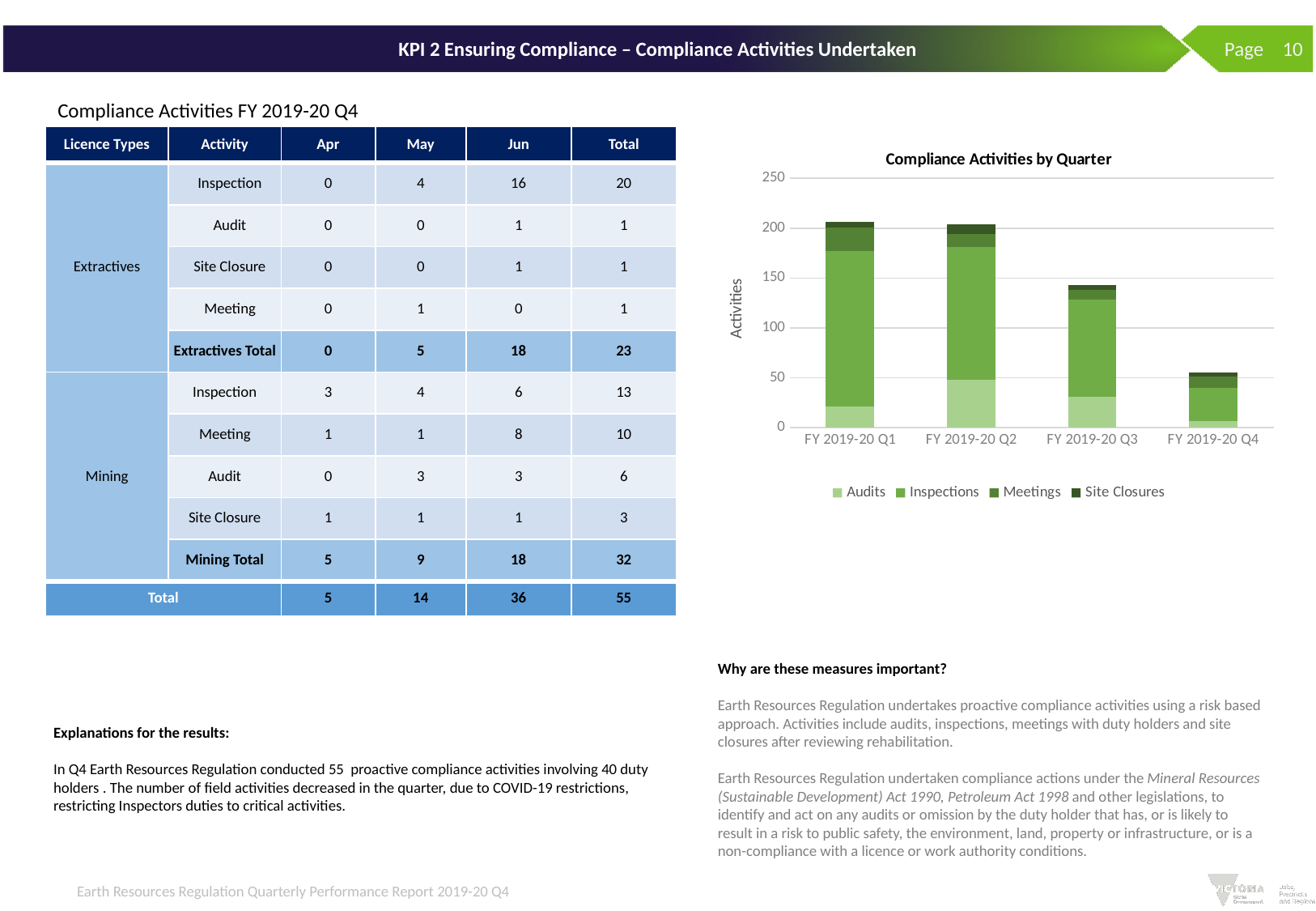
In the 'Compliance Activities by Quarter' chart, is the total for FY 2019-20 Q3 greater or less than 150? less What is the y-axis label of the 'Compliance Activities by Quarter' chart? Activities Which quarter has the lowest total in the 'Compliance Activities by Quarter' chart? FY 2019-20 Q4 In the 'Compliance Activities by Quarter' chart, is the total for FY 2019-20 Q1 greater or less than 200? greater In the 'Compliance Activities by Quarter' chart, is the total for FY 2019-20 Q2 greater or less than 150? greater In the 'Compliance Activities by Quarter' chart, which has the larger total, FY 2019-20 Q3 or FY 2019-20 Q4? FY 2019-20 Q3 What type of chart is 'Compliance Activities by Quarter'? stacked bar chart How many series does the legend of the 'Compliance Activities by Quarter' chart list? 4 Which series is listed first in the legend of the 'Compliance Activities by Quarter' chart? Audits How many quarters are shown on the x axis of the 'Compliance Activities by Quarter' chart? 4 Do the total compliance activities rise or fall from FY 2019-20 Q2 to FY 2019-20 Q4 in the 'Compliance Activities by Quarter' chart? fall